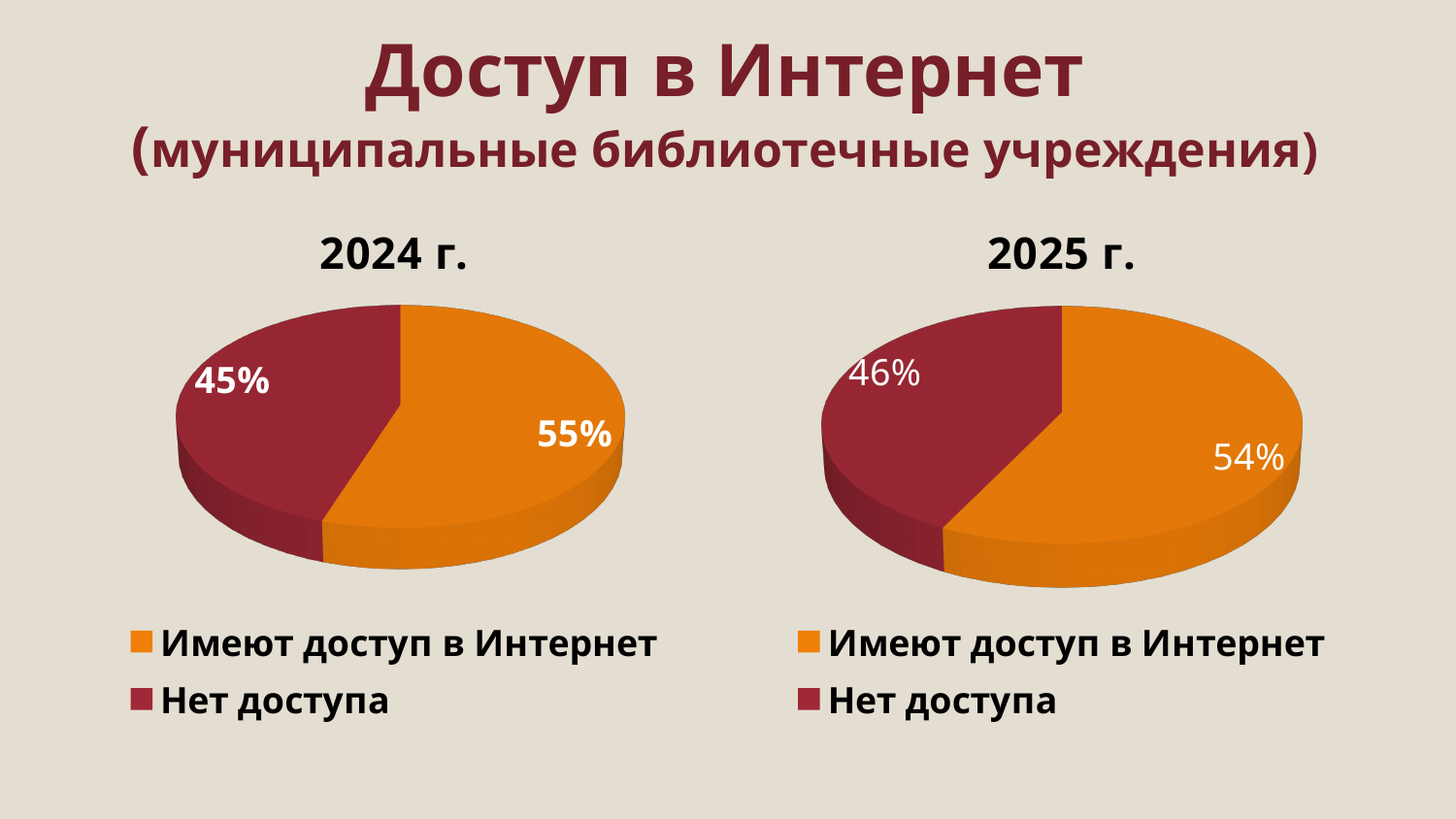
In the 2025 г. chart, which slice is the smallest? Нет доступа How many entries does the legend of the 2024 г. chart list? 2 In the 2025 г. pie chart, what share is labelled Нет доступа? 46% In the 2024 г. pie chart, what share is labelled Нет доступа? 45% How many slices does the 2025 г. pie chart have? 2 In the 2025 г. pie chart, what share of libraries have Internet access (Имеют доступ в Интернет)? 54% What type of chart is used on this slide for 2024 г. and 2025 г.? Pie chart In the 2024 г. chart, what is the difference between the Имеют доступ в Интернет and Нет доступа shares? 10% In the 2024 г. chart, which slice is larger: Имеют доступ в Интернет or Нет доступа? Имеют доступ в Интернет In the 2024 г. pie chart, what share of municipal libraries have Internet access (Имеют доступ в Интернет)? 55% What colour represents Нет доступа in the charts? Dark red In the 2025 г. chart, what is the difference between the Имеют доступ в Интернет and Нет доступа shares? 8%